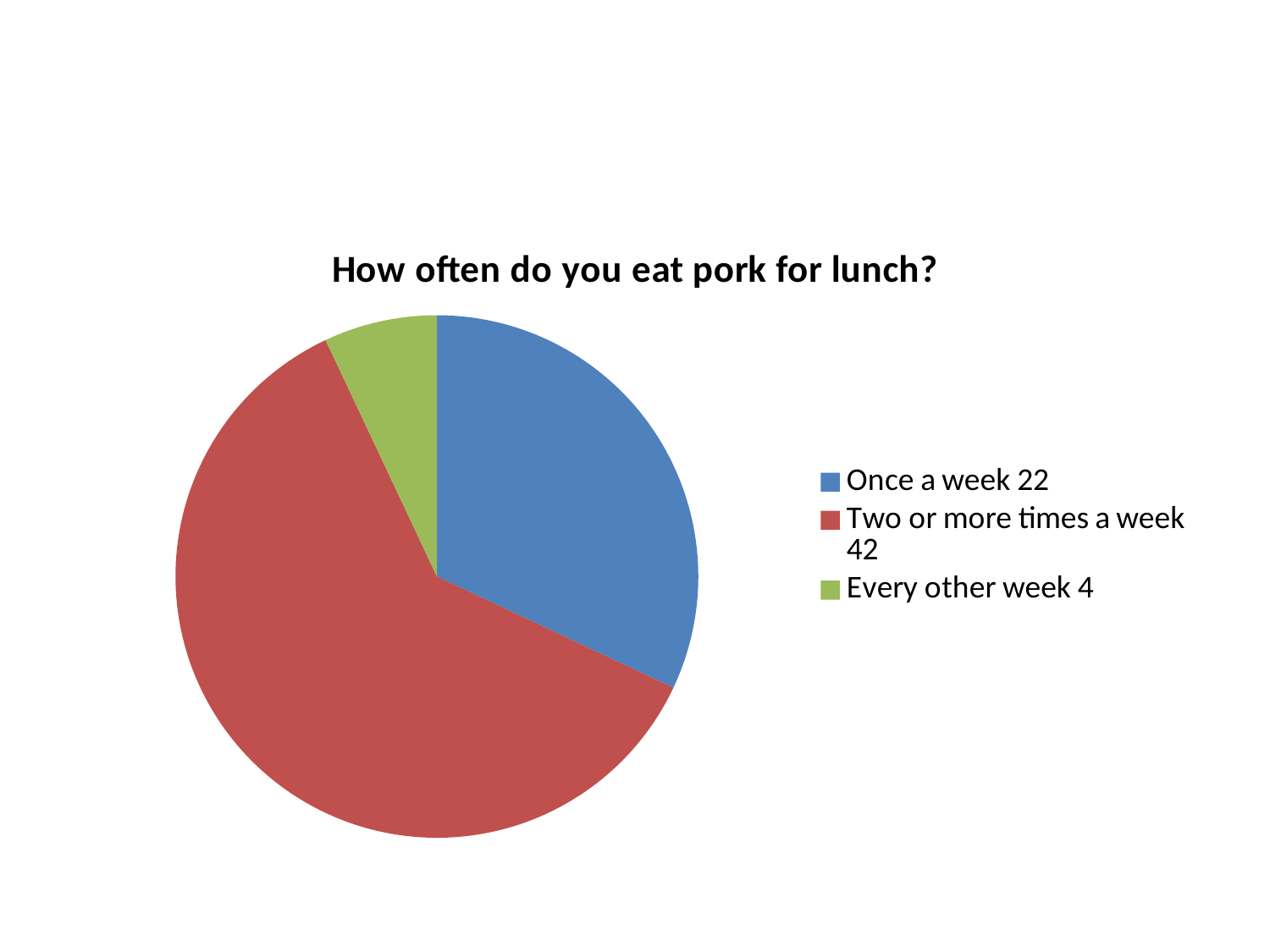
What kind of chart is shown on the slide? Pie chart Which category has the largest slice of the pie? Two or more times a week How many categories are shown in the pie chart? 3 What is the value for Every other week? 4 What is the total of all the values shown in the legend? 68 What is the difference between the values for Once a week and Every other week? 18 Which is larger, Once a week or Every other week? Once a week What is the title of the chart? How often do you eat pork for lunch? Which category has the smallest slice of the pie? Every other week What is the difference between the values for Two or more times a week and Once a week? 20 What is the value for Once a week? 22 What is the value for Two or more times a week? 42